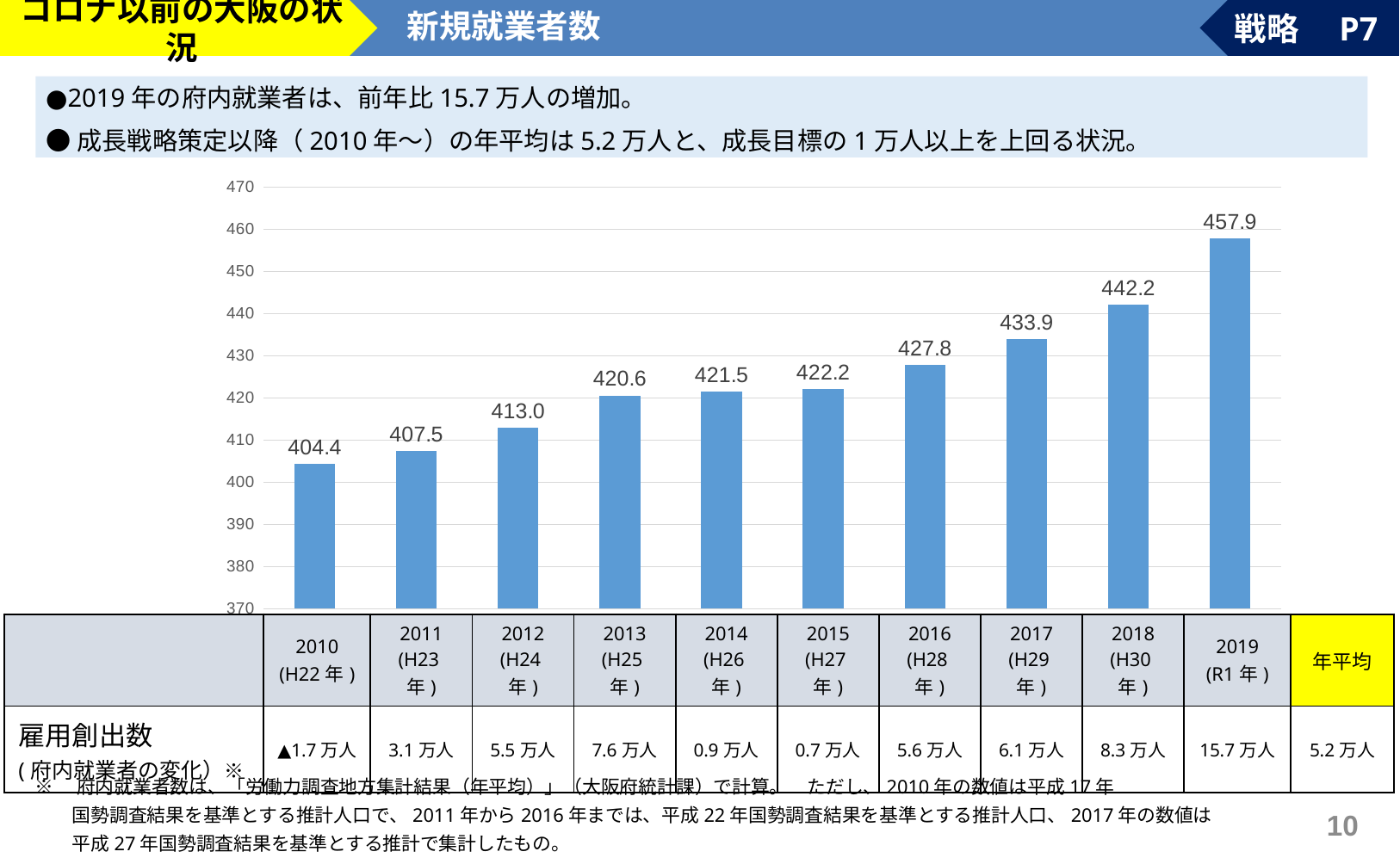
What is the value for 2014 (H26年) in the bar chart? 421.5 What kind of chart is shown on the slide? bar chart Which is larger in the bar chart, the value for 2017 or the value for 2016? 2017 Which year has the lowest bar in the chart? 2010 (H22年) What is the difference between the values for 2019 and 2018 in the bar chart? 15.7 What is the value for 2010 (H22年) in the bar chart? 404.4 What is the difference between the values for 2012 and 2011 in the bar chart? 5.5 Which year has the highest bar in the chart? 2019 (R1年) Do the values in the bar chart rise or fall from 2010 to 2019? rise Is the value for 2013 in the bar chart greater or less than 410? greater What is the value for 2019 (R1年) in the bar chart? 457.9 How many bars are plotted in the chart? 10